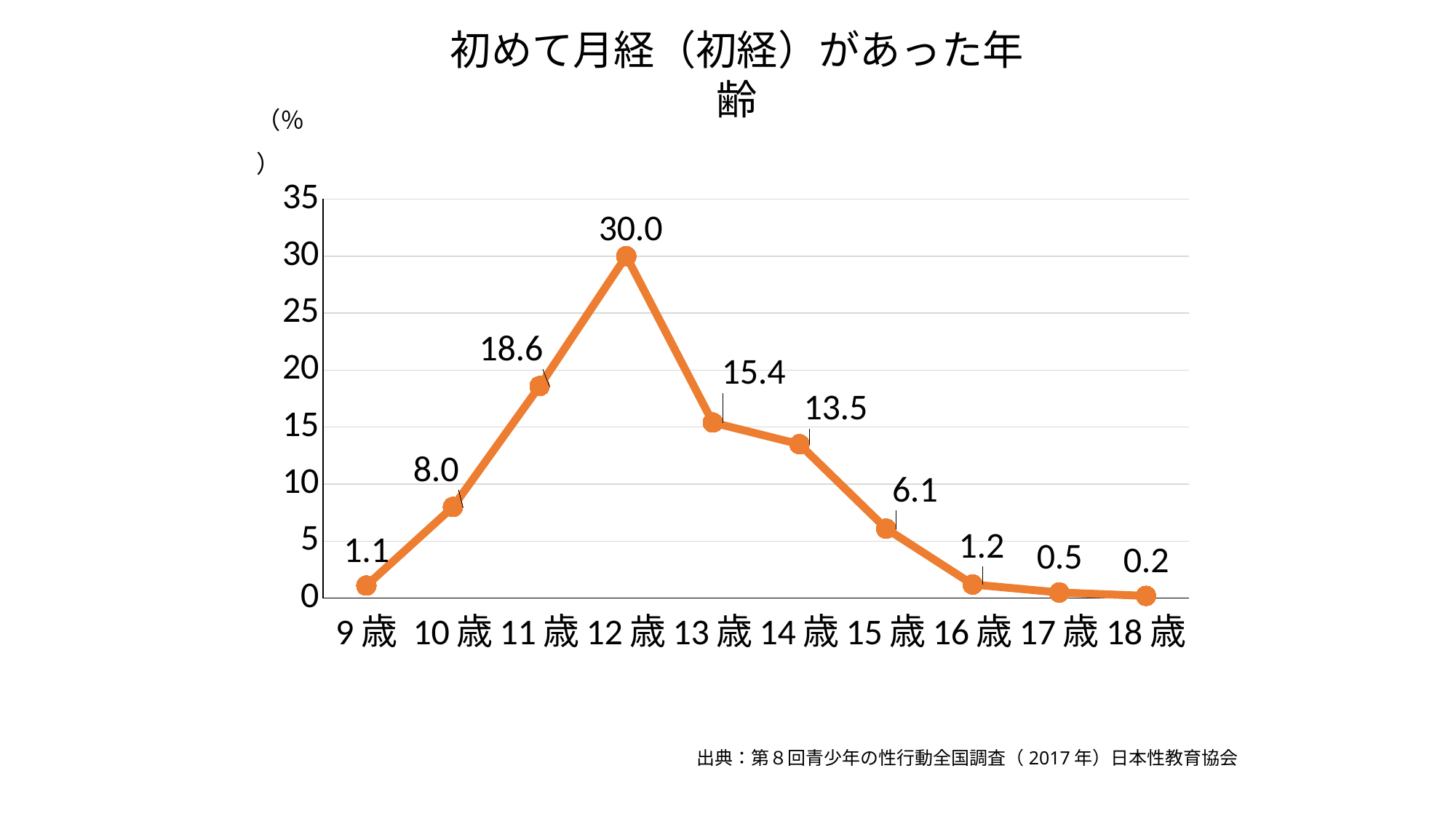
Is the value for 11歳 greater or less than 15? greater What is the value for 9歳? 1.1 Which age has the highest value? 12歳 What is the value for 12歳? 30.0 What kind of chart is shown on the slide? line chart Which age has the lowest value? 18歳 Which is larger, the value for 10歳 or the value for 15歳? 10歳 What is the difference between the values for 12歳 and 11歳? 11.4 What is the difference between the values for 13歳 and 14歳? 1.9 How many age categories are plotted on the x axis? 10 What is the value for 15歳? 6.1 Do the values rise or fall from 12歳 to 18歳? fall